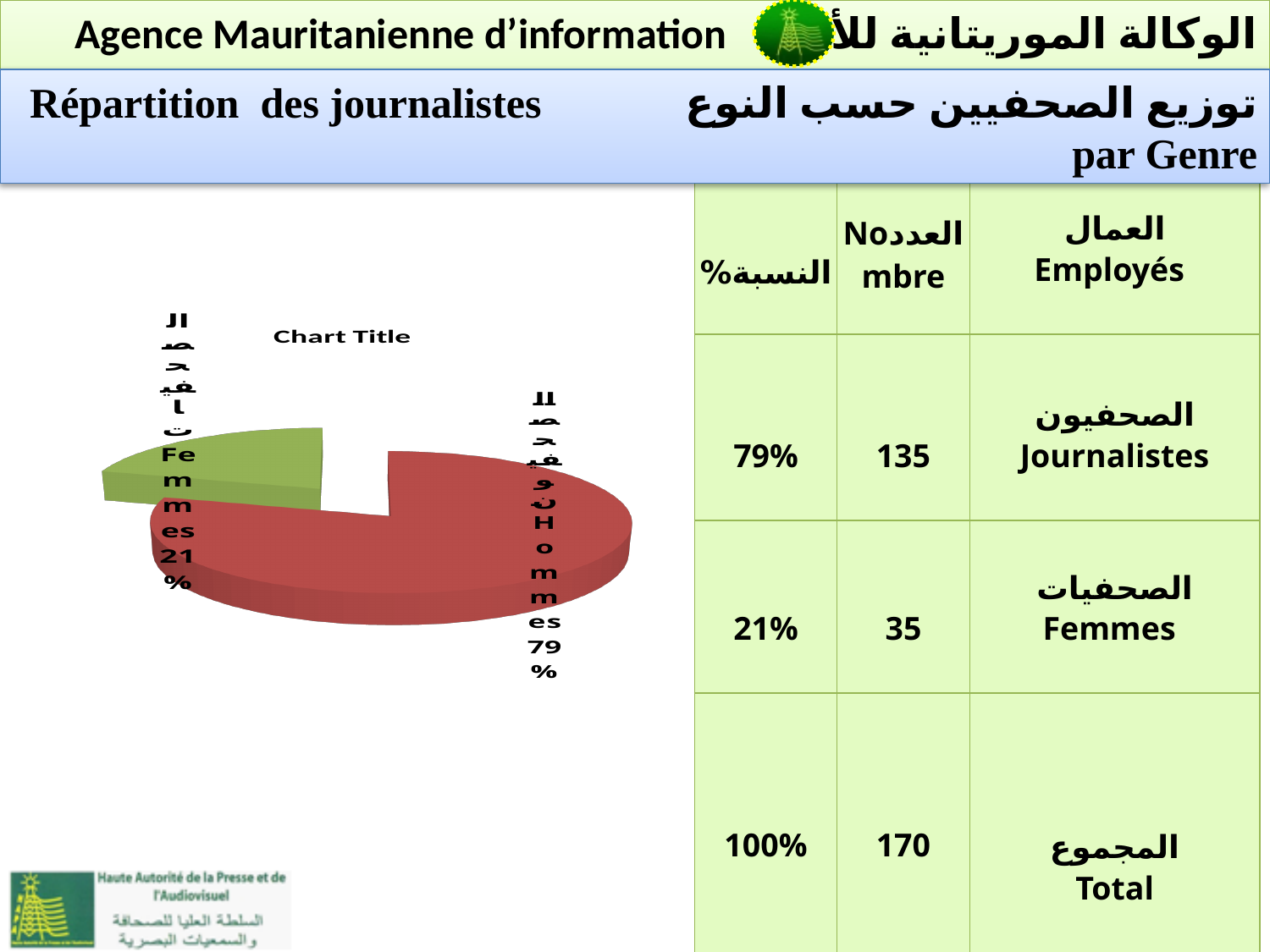
How many slices does the pie chart have? 2 What kind of chart is shown on the slide? pie chart What share of the pie does the Hommes slice represent? 79% Which slice of the pie is the largest? Hommes Which slice of the pie is the smallest? Femmes Which is larger, the Hommes slice or the Femmes slice? Hommes What is the title printed on the pie chart? Chart Title What colour is the Femmes slice of the pie? green What is the difference in percentage points between the Hommes and Femmes slices? 58 What share of the pie does the Femmes slice represent? 21%